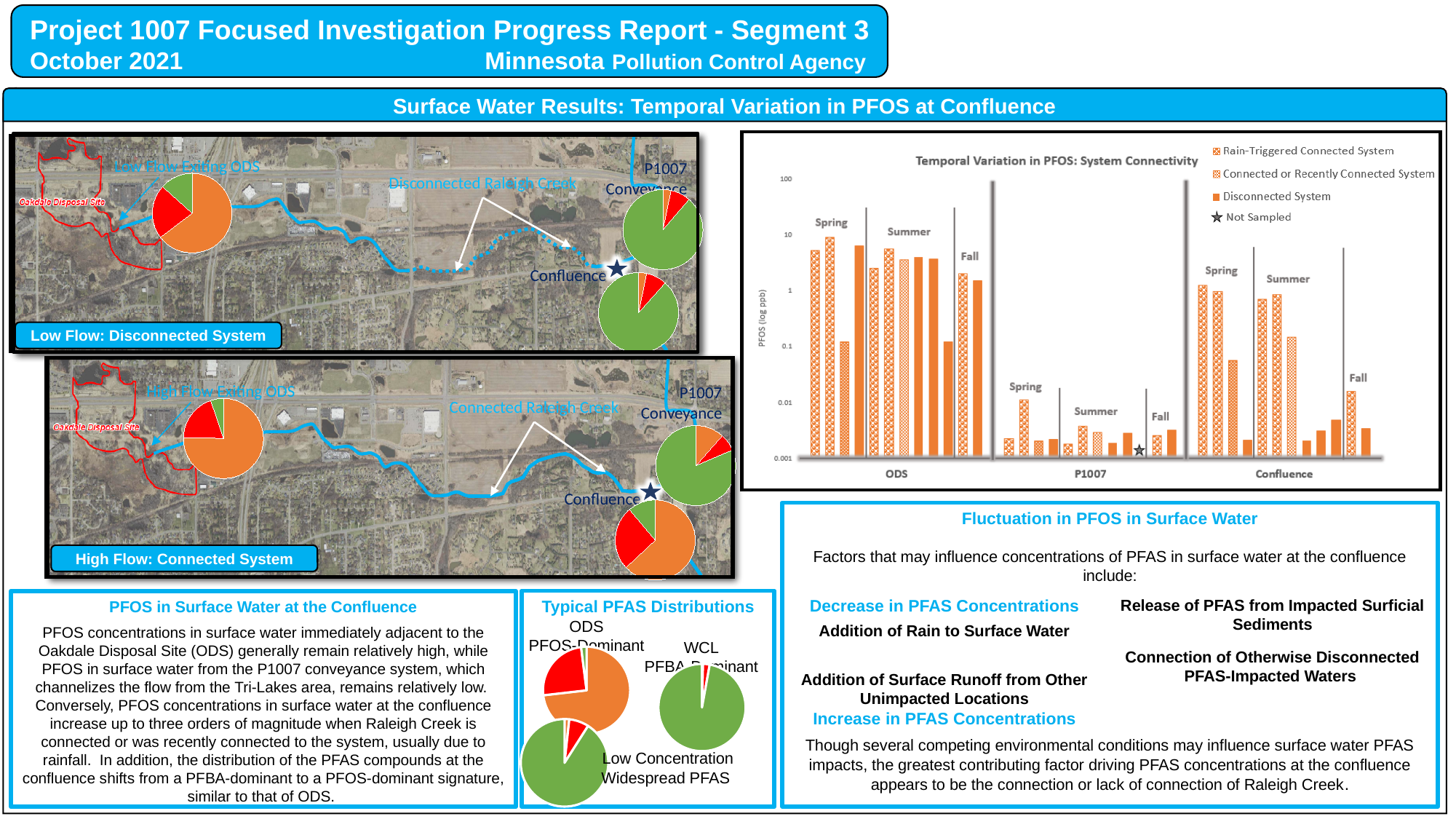
In the 'Temporal Variation in PFOS' chart, which site group has a 'Not Sampled' star marker? P1007 How many entries does the legend of the 'Temporal Variation in PFOS: System Connectivity' chart list? 4 In the 'Temporal Variation in PFOS' chart, is the tallest bar for ODS greater or less than 1? greater In the 'Temporal Variation in PFOS' chart, is the tallest bar for Confluence greater or less than 10? less What kind of chart is 'Temporal Variation in PFOS: System Connectivity'? bar chart In the 'Temporal Variation in PFOS' chart, do the Confluence values generally rise or fall from Spring to Fall? fall What is the y-axis label of the 'Temporal Variation in PFOS' chart? PFOS (log ppb) How many site groups are shown along the x axis of the 'Temporal Variation in PFOS' chart? 3 In the 'Temporal Variation in PFOS' chart, which site group has the lowest PFOS values overall? P1007 In the 'Temporal Variation in PFOS' chart, are the Spring values at the Confluence larger or smaller than the Fall values at the Confluence? larger In the 'Temporal Variation in PFOS' chart, which site group has the highest PFOS values overall? ODS In the 'Temporal Variation in PFOS' chart, is the tallest bar for P1007 greater or less than 0.1? less